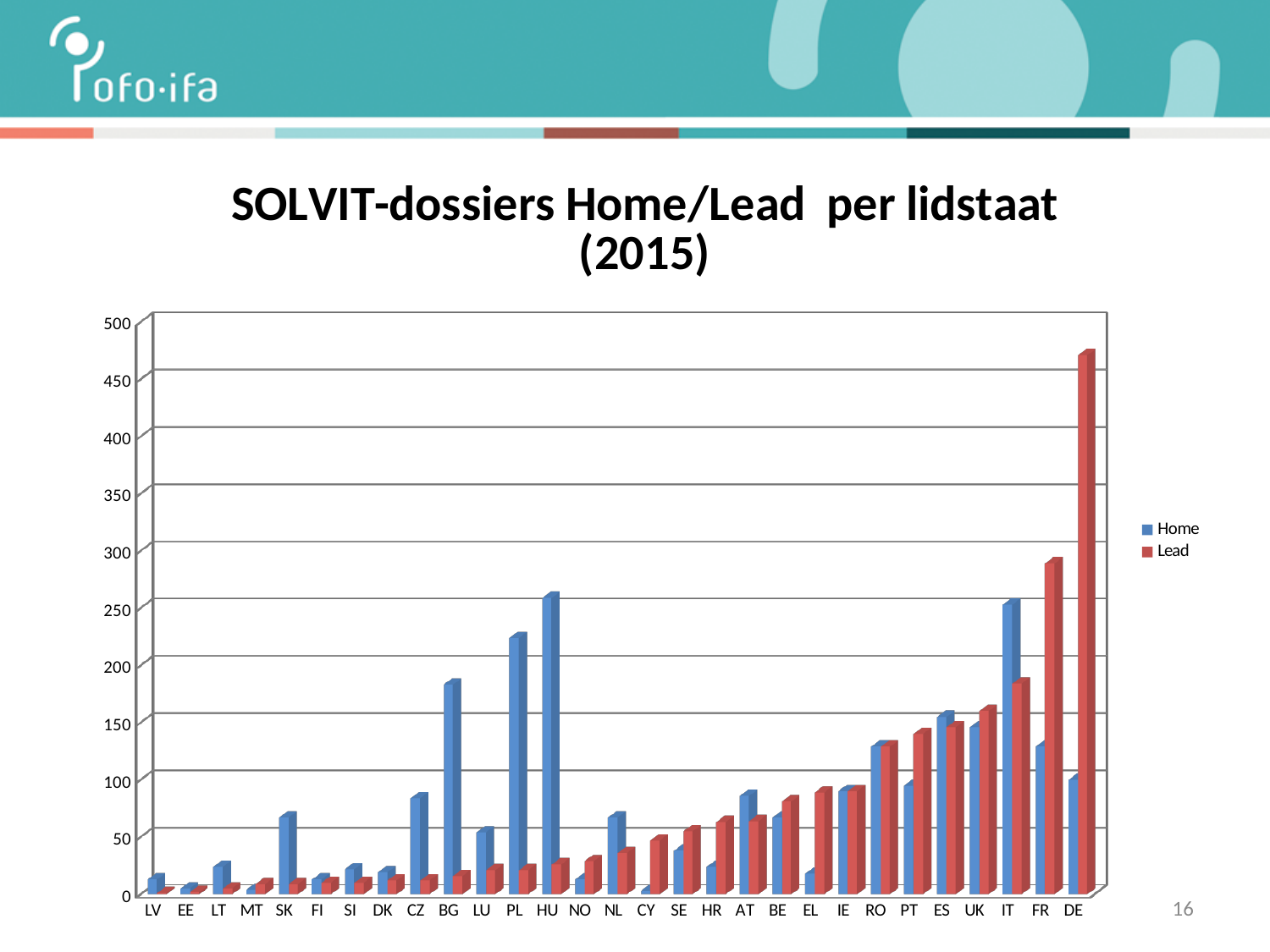
What kind of chart is shown on the slide? bar chart Is the Lead value for FR greater or less than 250? greater Which member state has the highest Lead value? DE Is the Home value for BG greater or less than 150? greater What is the title of the chart? SOLVIT-dossiers Home/Lead per lidstaat (2015) Which is larger for BG, the Home value or the Lead value? Home Which member state has the highest Home value? HU Is the Lead value for DE greater or less than 450? greater Do the Lead values generally rise or fall from left to right along the x axis? rise How many series does the legend list? 2 How many member states (categories) are shown on the x axis? 29